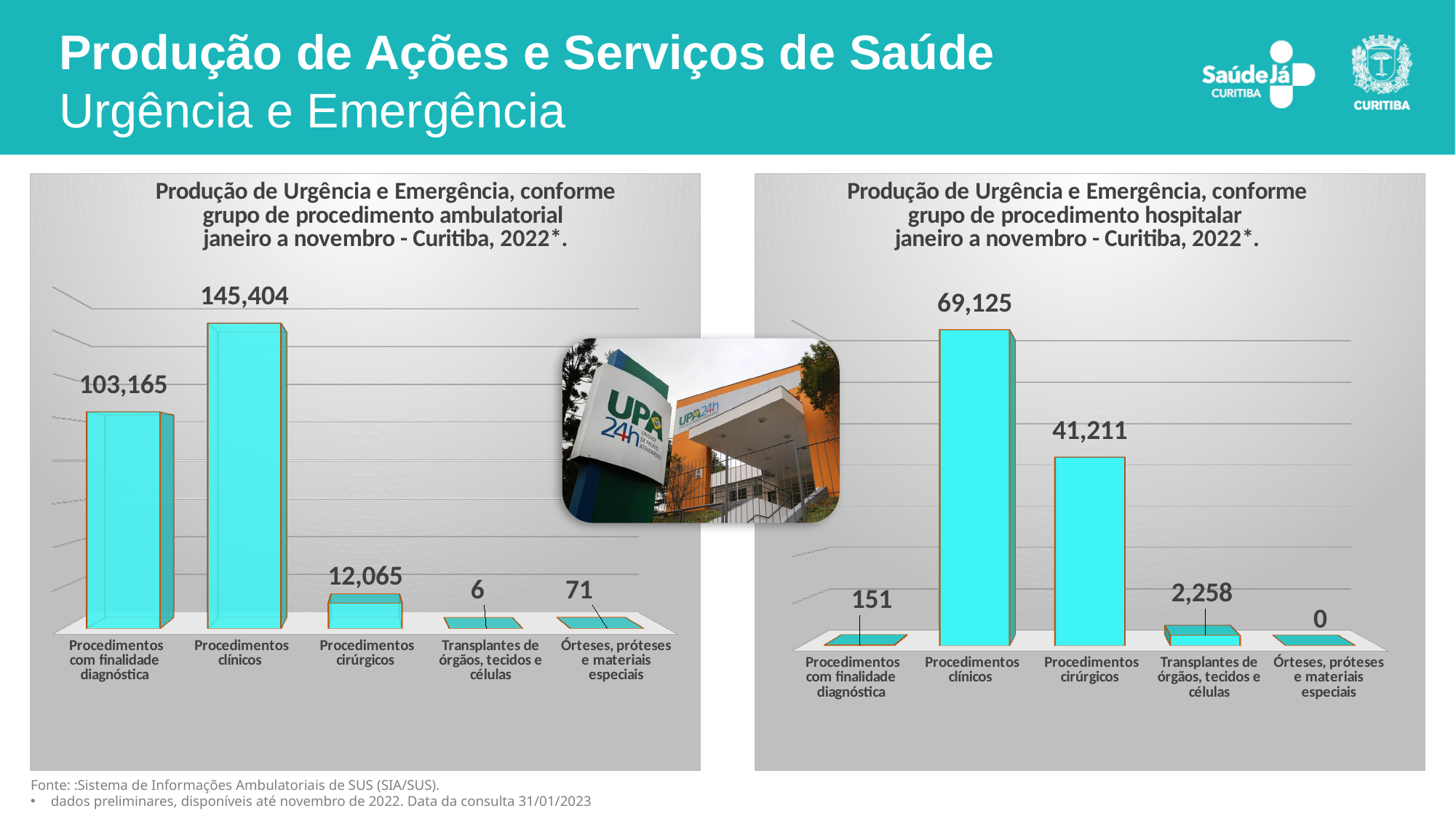
In the right chart (procedimento hospitalar), what is the value for Órteses, próteses e materiais especiais? 0 In the right chart (procedimento hospitalar), what is the value for Transplantes de órgãos, tecidos e células? 2,258 In the left chart (procedimento ambulatorial), which category has the lowest value? Transplantes de órgãos, tecidos e células How many categories are shown in the left chart (procedimento ambulatorial)? 5 In the right chart (procedimento hospitalar), what is the difference between Procedimentos clínicos and Procedimentos cirúrgicos? 27,914 In the right chart (procedimento hospitalar), which category has the highest value? Procedimentos clínicos In the left chart (procedimento ambulatorial), what is the value for Procedimentos com finalidade diagnóstica? 103,165 In the right chart (procedimento hospitalar), which is larger: Procedimentos com finalidade diagnóstica or Transplantes de órgãos, tecidos e células? Transplantes de órgãos, tecidos e células In the left chart (procedimento ambulatorial), what is the difference between Procedimentos clínicos and Procedimentos com finalidade diagnóstica? 42,239 In the left chart (procedimento ambulatorial), what is the value for Procedimentos clínicos? 145,404 In the right chart (procedimento hospitalar), what is the value for Procedimentos cirúrgicos? 41,211 What kind of chart is the right chart (procedimento hospitalar)? Bar chart